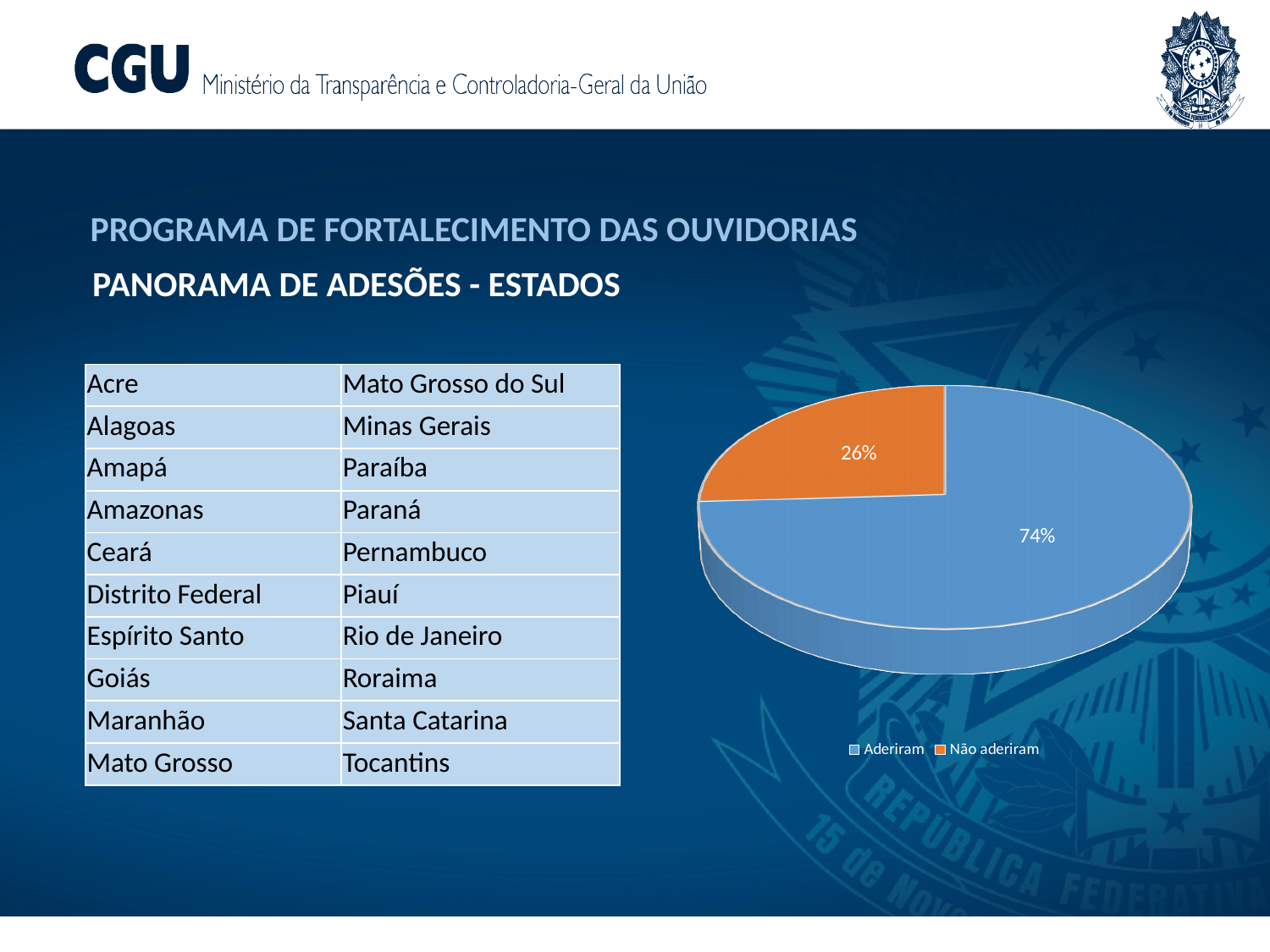
Which slice of the pie is the largest? Aderiram What share of the pie does the "Aderiram" slice represent? 74% What share of the pie does the "Não aderiram" slice represent? 26% Which slice of the pie is the smallest? Não aderiram How many slices does the pie chart have? 2 What colour is the "Não aderiram" slice in the pie chart? orange Which is larger, the "Aderiram" slice or the "Não aderiram" slice? Aderiram What kind of chart is shown on the slide? pie chart What is the difference in percentage points between the "Aderiram" and "Não aderiram" slices? 48 What colour is the "Aderiram" slice in the pie chart? blue How many entries does the chart legend list? 2